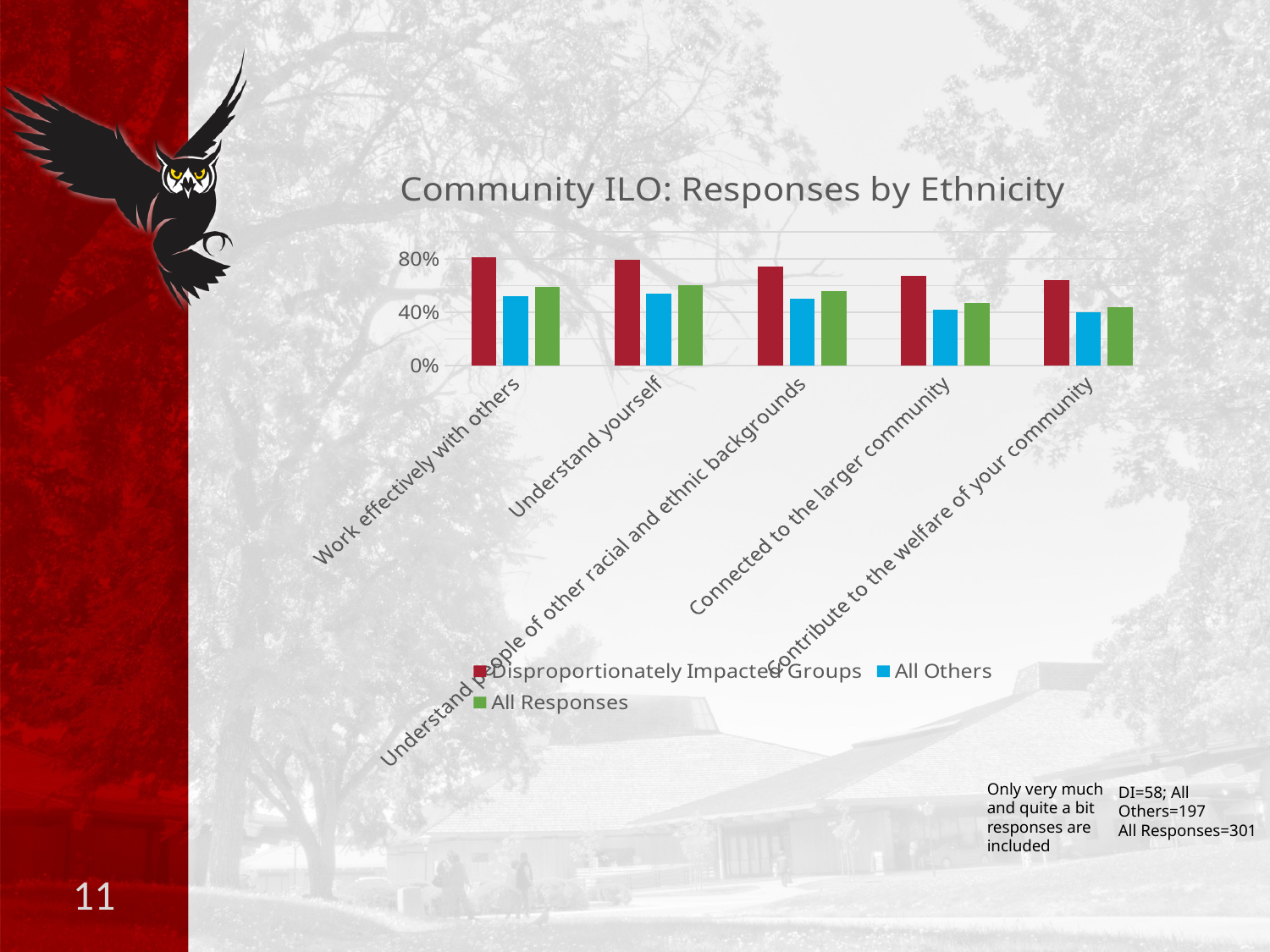
What kind of chart is shown on the slide? bar chart Is the All Others value for 'Work effectively with others' greater or less than 40%? greater Which series is shown in red in the chart? Disproportionately Impacted Groups For 'Understand yourself', which series has the larger value: All Others or All Responses? All Responses What is the title of the chart? Community ILO: Responses by Ethnicity Is the Disproportionately Impacted Groups value for 'Contribute to the welfare of your community' greater or less than 80%? less How many categories are shown along the x axis of the chart? 5 Within the 'Contribute to the welfare of your community' category, which series has the highest value? Disproportionately Impacted Groups Is the Disproportionately Impacted Groups value for 'Work effectively with others' greater or less than 40%? greater How many series does the chart's legend list? 3 Do the Disproportionately Impacted Groups values rise or fall moving from left to right across the categories? fall For 'Connected to the larger community', which series has the larger value: Disproportionately Impacted Groups or All Others? Disproportionately Impacted Groups